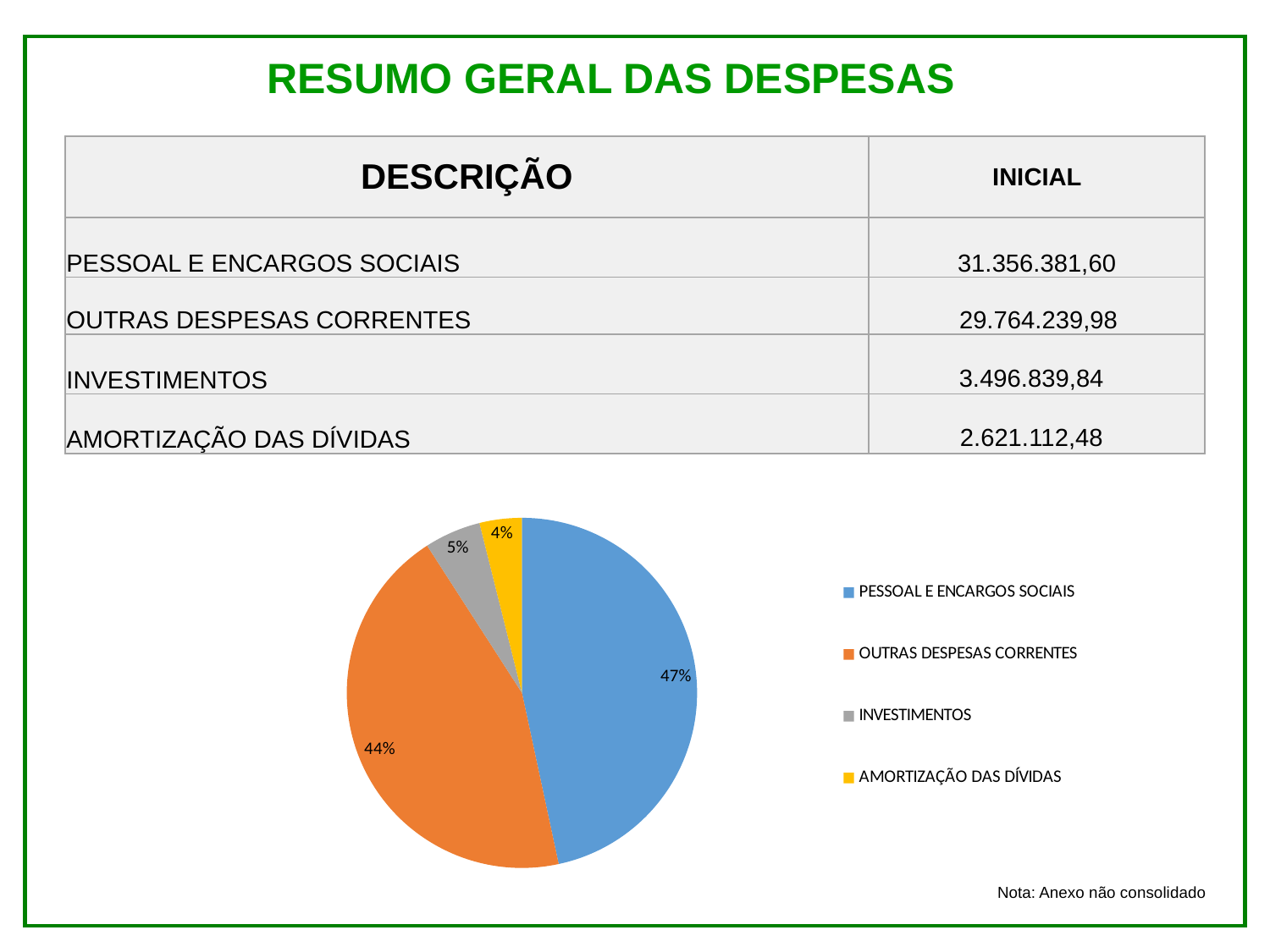
How many slices does the pie chart have? 4 What share of the pie does PESSOAL E ENCARGOS SOCIAIS represent? 47% What is the difference in percentage points between the PESSOAL E ENCARGOS SOCIAIS slice and the OUTRAS DESPESAS CORRENTES slice? 3 percentage points How many entries does the legend list? 4 What colour is the slice for OUTRAS DESPESAS CORRENTES? orange What share of the pie does OUTRAS DESPESAS CORRENTES represent? 44% What kind of chart is shown on the slide? pie chart What share of the pie does AMORTIZAÇÃO DAS DÍVIDAS represent? 4% Which category has the smallest slice of the pie? AMORTIZAÇÃO DAS DÍVIDAS Which slice is larger, INVESTIMENTOS or AMORTIZAÇÃO DAS DÍVIDAS? INVESTIMENTOS Which category has the largest slice of the pie? PESSOAL E ENCARGOS SOCIAIS